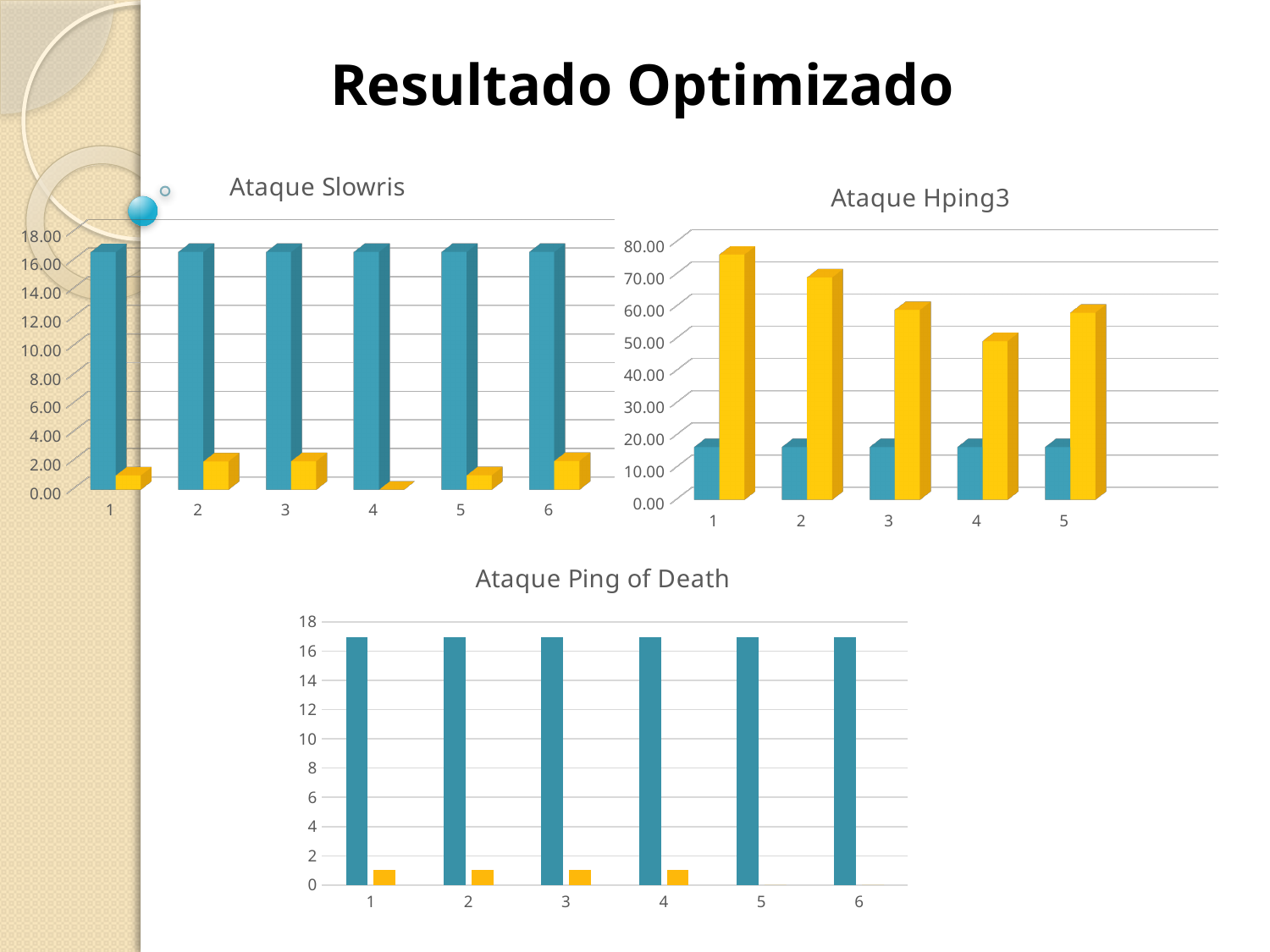
In the "Ataque Hping3" chart, which is taller for category 2: the teal bar or the yellow bar? the yellow bar How many categories are shown on the x axis of the "Ataque Slowris" chart? 6 In the "Ataque Hping3" chart, is the yellow bar for category 4 greater or less than 60.00? less What kind of chart is the "Ataque Ping of Death" chart? bar chart In the "Ataque Ping of Death" chart, is the yellow bar for category 2 greater or less than 2? less In the "Ataque Hping3" chart, which category has the shortest yellow bar? 4 In the "Ataque Ping of Death" chart, is the teal bar for category 1 greater or less than 10? greater What is the title of the chart at the bottom of the slide? Ataque Ping of Death How many categories are shown on the x axis of the "Ataque Hping3" chart? 5 In the "Ataque Hping3" chart, which category has the tallest yellow bar? 1